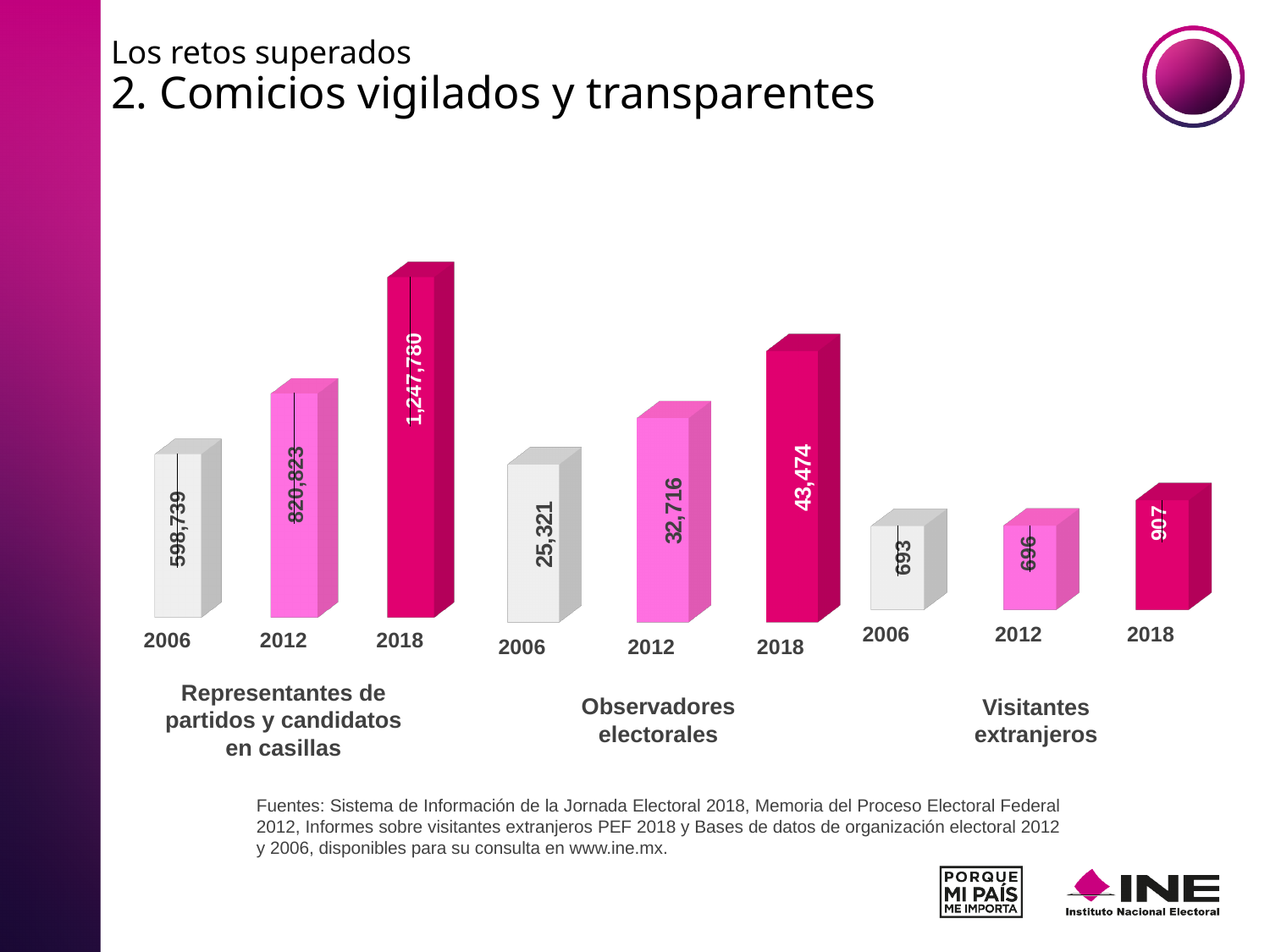
In the 'Observadores electorales' chart, what is the difference between the 2018 and 2006 values? 18,153 In the 'Observadores electorales' chart, which year has the highest value? 2018 In the 'Visitantes extranjeros' chart, what is the difference between the 2018 and 2012 values? 211 In the 'Representantes de partidos y candidatos en casillas' chart, what is the difference between the 2018 and 2012 values? 426,957 In the 'Representantes de partidos y candidatos en casillas' chart, what is the value for 2006? 598,739 In the 'Visitantes extranjeros' chart, what is the value for 2018? 907 In the 'Visitantes extranjeros' chart, which year has the lowest value? 2006 In the 'Observadores electorales' chart, what is the value for 2012? 32,716 In the 'Observadores electorales' chart, which is larger, the value for 2006 or the value for 2012? 2012 How many years are shown in the 'Representantes de partidos y candidatos en casillas' chart? 3 What kind of chart is the 'Visitantes extranjeros' chart? Bar chart In the 'Representantes de partidos y candidatos en casillas' chart, what is the value for 2018? 1,247,780